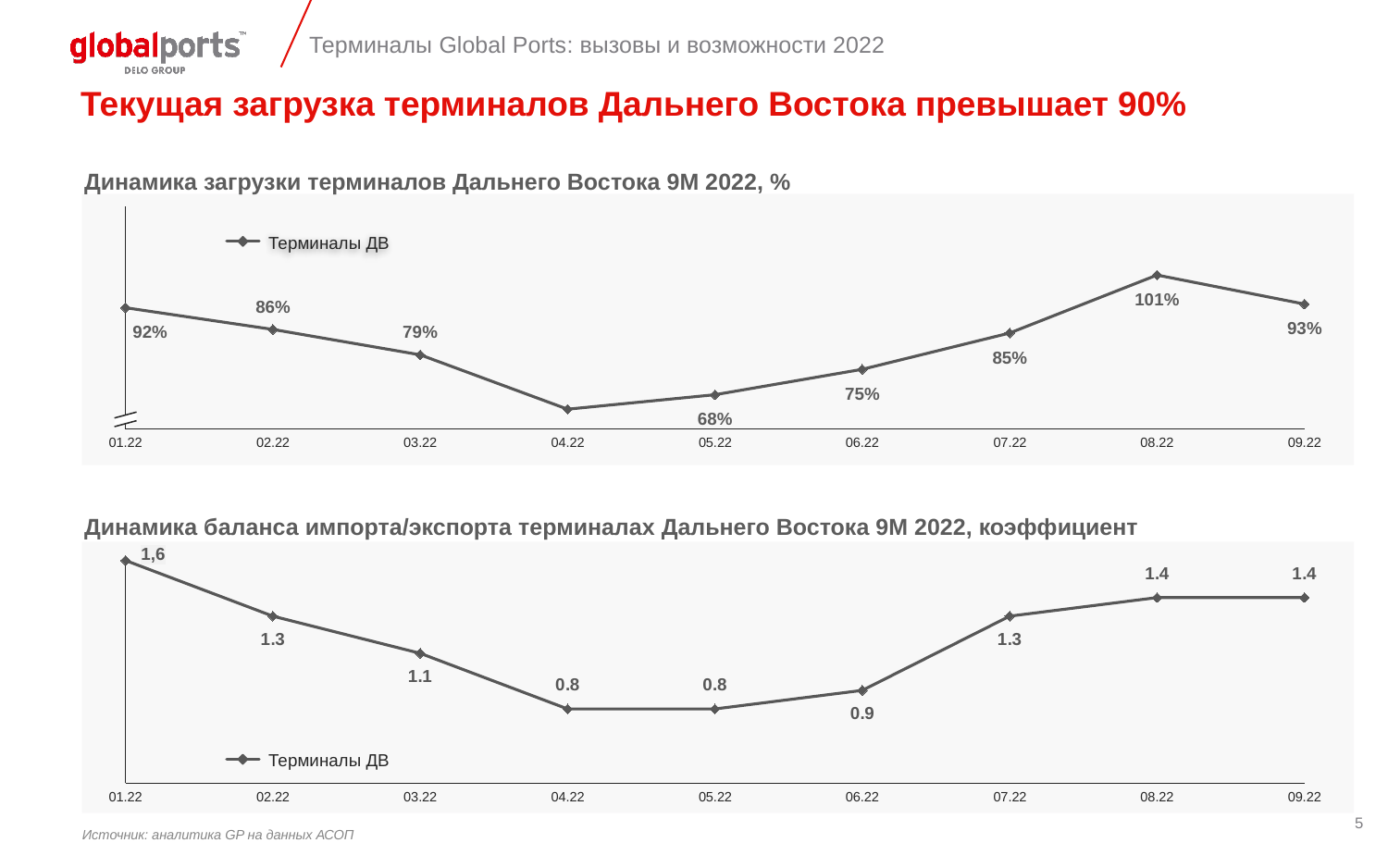
What series name does the legend of the bottom chart (Динамика баланса импорта/экспорта терминалах Дальнего Востока 9M 2022, коэффициент) show? Терминалы ДВ In the top chart (Динамика загрузки терминалов Дальнего Востока 9M 2022, %), which month has the highest labelled value? 08.22 In the top chart (Динамика загрузки терминалов Дальнего Востока 9M 2022, %), which is larger: the value for 02.22 or the value for 07.22? 02.22 In the bottom chart (Динамика баланса импорта/экспорта терминалах Дальнего Востока 9M 2022, коэффициент), which month has the highest value? 01.22 In the top chart (Динамика загрузки терминалов Дальнего Востока 9M 2022, %), what is the value for 08.22? 101% In the bottom chart (Динамика баланса импорта/экспорта терминалах Дальнего Востока 9M 2022, коэффициент), do the values rise or fall from 01.22 to 04.22? Fall In the bottom chart (Динамика баланса импорта/экспорта терминалах Дальнего Востока 9M 2022, коэффициент), what is the value for 06.22? 0.9 In the top chart (Динамика загрузки терминалов Дальнего Востока 9M 2022, %), what is the difference between the values for 08.22 and 09.22? 8% In the bottom chart (Динамика баланса импорта/экспорта терминалах Дальнего Востока 9M 2022, коэффициент), what is the value for 01.22? 1,6 What kind of chart is the top chart (Динамика загрузки терминалов Дальнего Востока 9M 2022, %)? Line chart In the top chart (Динамика загрузки терминалов Дальнего Востока 9M 2022, %), how many months are shown on the x axis? 9 In the top chart (Динамика загрузки терминалов Дальнего Востока 9M 2022, %), what is the value for 01.22? 92%